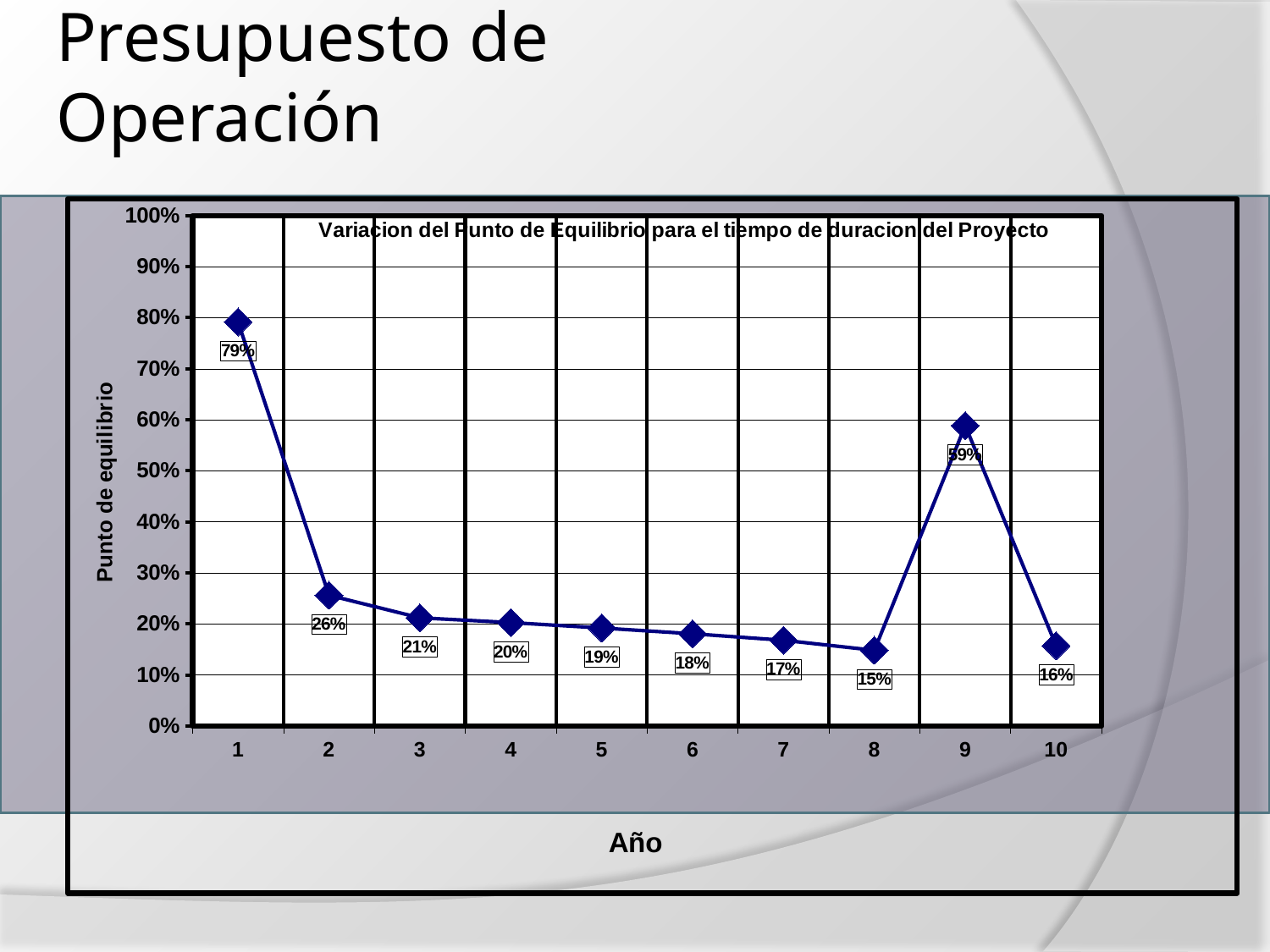
Which year has the highest value? 1 What kind of chart is shown? line chart Is the value for year 9 greater or less than 50%? greater What is the difference between the values for year 9 and year 10? 43% What is the value for year 9? 59% What is the label of the y axis? Punto de equilibrio Which year has the lowest value? 8 Which is larger, the value for year 3 or the value for year 7? year 3 What is the difference between the values for year 1 and year 2? 53% What is the value for year 5? 19% What is the value for year 1? 79% How many years are plotted on the x axis? 10